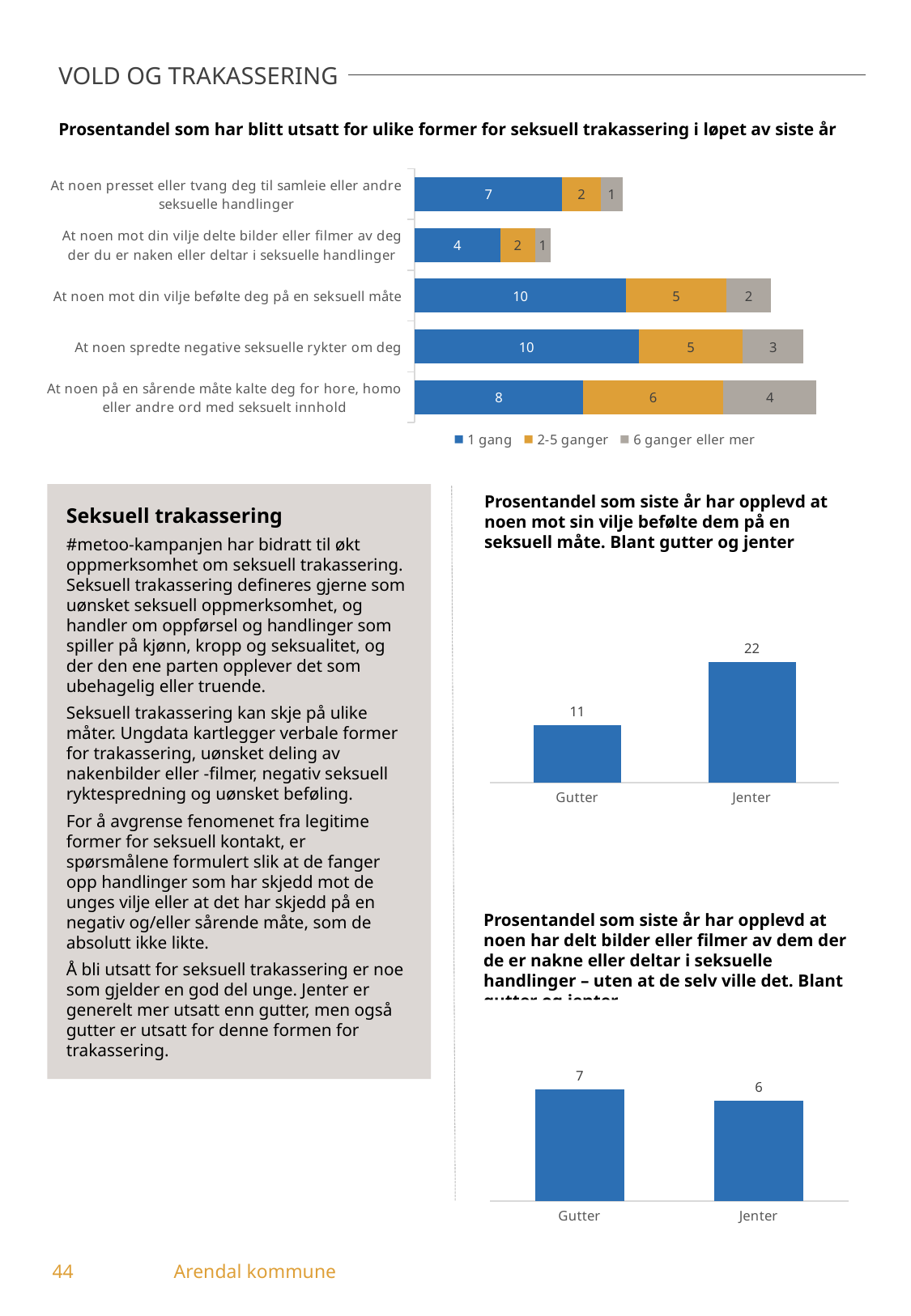
In the top stacked bar chart, what is the value for '6 ganger eller mer' for 'At noen på en sårende måte kalte deg for hore, homo eller andre ord med seksuelt innhold'? 4 How many series does the legend of the top stacked bar chart list? 3 How many categories are shown in the top stacked bar chart? 5 In the top stacked bar chart, what is the total for 'At noen mot din vilje delte bilder eller filmer av deg der du er naken eller deltar i seksuelle handlinger'? 7 In the top stacked bar chart, what is the total for 'At noen spredte negative seksuelle rykter om deg'? 18 In the chart titled 'Prosentandel som siste år har opplevd at noen mot sin vilje befølte dem på en seksuell måte', what is the difference between Jenter and Gutter? 11 What kind of chart is the top chart on the slide? Stacked bar chart In the top stacked bar chart, what is the value for '1 gang' for 'At noen mot din vilje befølte deg på en seksuell måte'? 10 In the bottom right chart about delte bilder eller filmer, what is the value for Jenter? 6 In the bottom right chart about delte bilder eller filmer, which is larger, Gutter or Jenter? Gutter In the chart titled 'Prosentandel som siste år har opplevd at noen mot sin vilje befølte dem på en seksuell måte', what is the value for Jenter? 22 In the top stacked bar chart, which category has the lowest '1 gang' value? At noen mot din vilje delte bilder eller filmer av deg der du er naken eller deltar i seksuelle handlinger